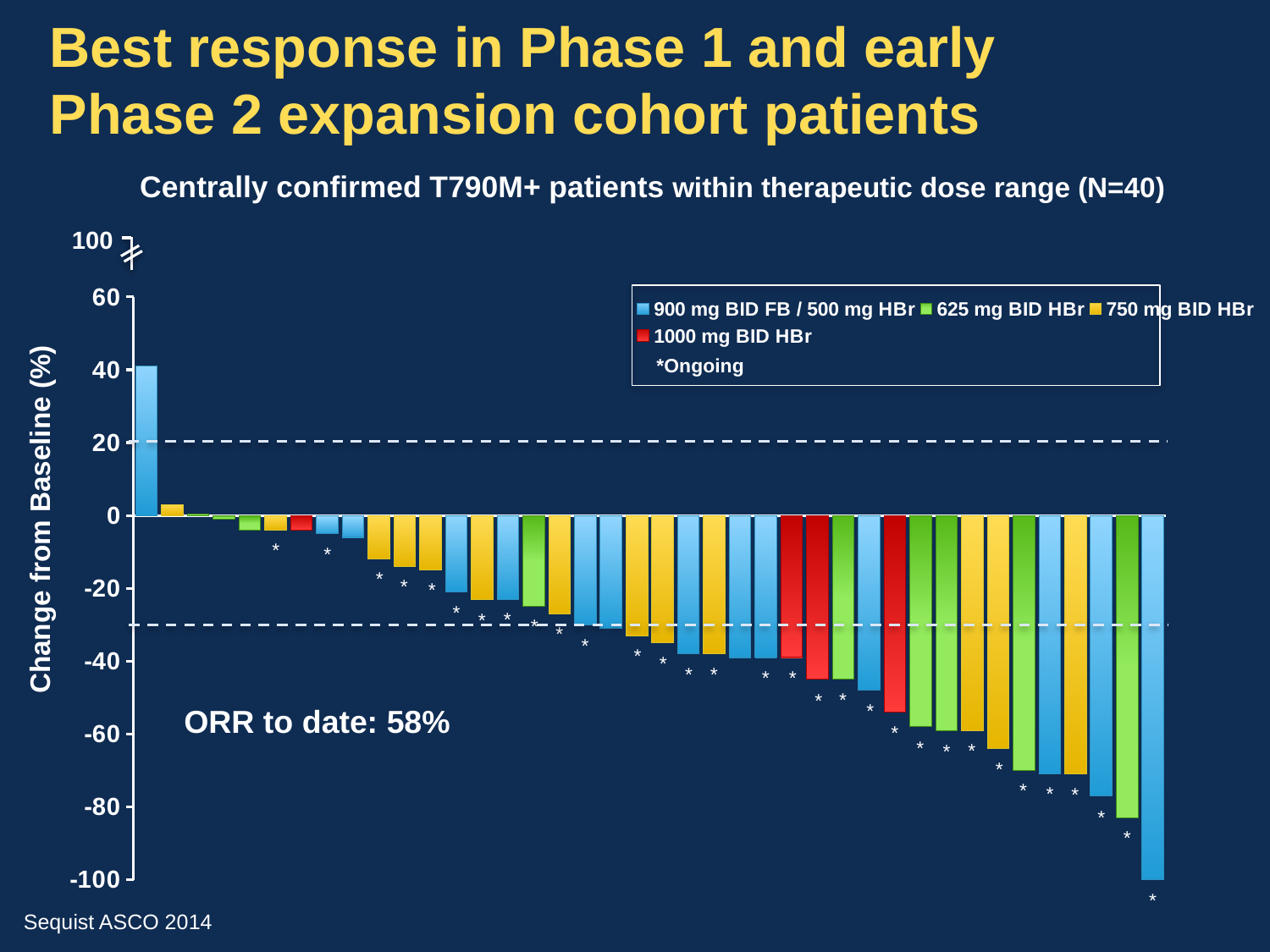
What is the highest value shown on the y axis? 100 What kind of chart is shown on the slide? Bar chart Is the value of the rightmost bar greater or less than -80? less Is the value of the leftmost bar greater or less than 20? greater Do the bar values rise or fall moving from left to right along the x axis? Fall What is the ORR to date stated on the chart? 58% Which bar has the highest value, the leftmost or the rightmost? The leftmost bar Which dose group does the red colour represent in the legend? 1000 mg BID HBr What is the lowest value shown on the y axis? -100 How many series does the legend list? 4 How many patients (bars) are represented in the chart, according to the subtitle? 40 What is the label of the y axis? Change from Baseline (%)